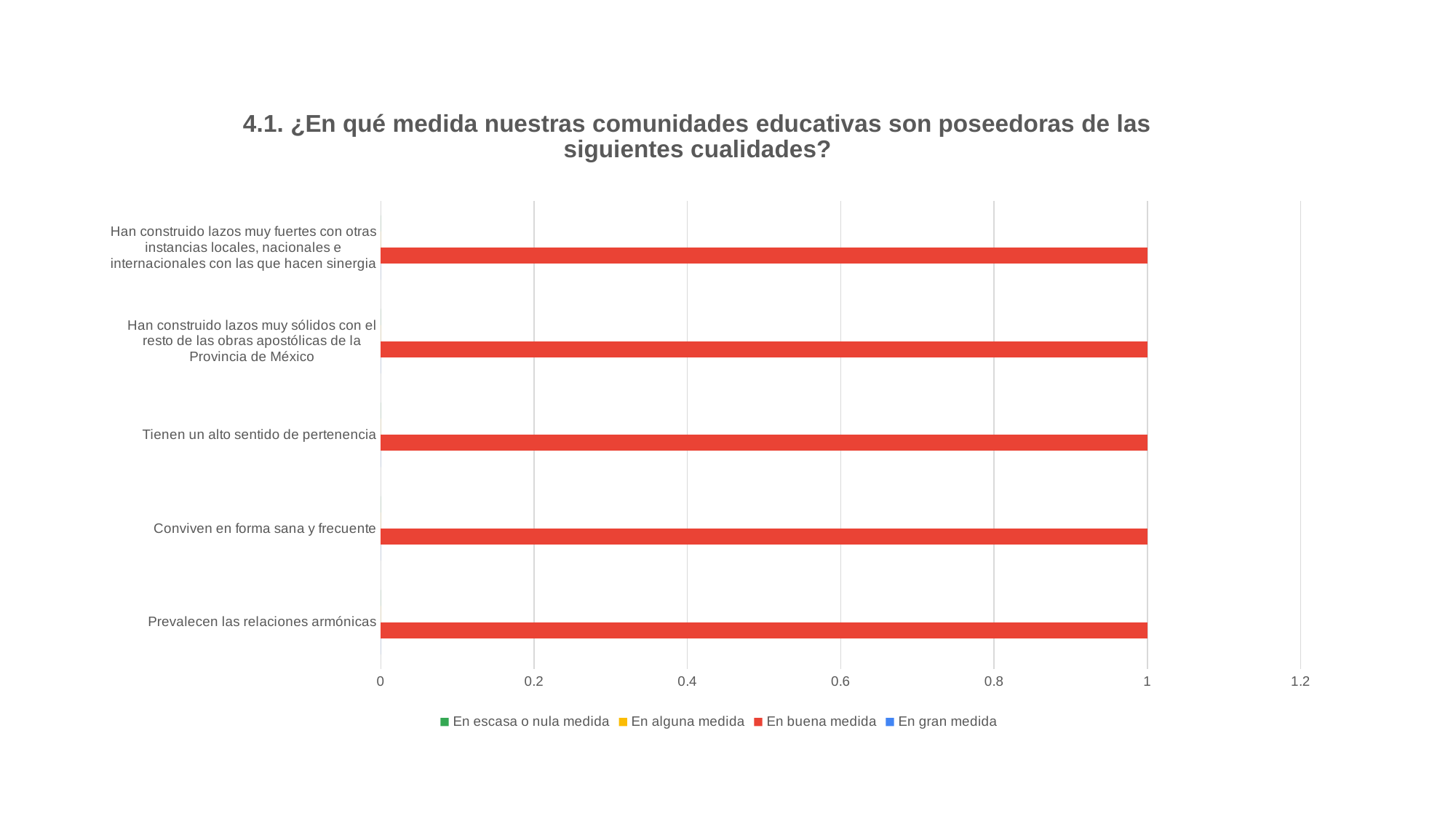
Which series in the legend is shown in red? En buena medida How many series does the legend list? 4 What is the value of the 'En buena medida' bar for 'Prevalecen las relaciones armónicas'? 1 What is the value of the 'En buena medida' bar for 'Tienen un alto sentido de pertenencia'? 1 Is the value for 'Han construido lazos muy sólidos con el resto de las obras apostólicas de la Provincia de México' greater or less than 1.2? less What is the highest value shown on the x axis? 1.2 How many categories are plotted on the chart? 5 What is the difference between the 'En buena medida' values for 'Tienen un alto sentido de pertenencia' and 'Prevalecen las relaciones armónicas'? 0 What is the title of the chart? 4.1. ¿En qué medida nuestras comunidades educativas son poseedoras de las siguientes cualidades? What kind of chart is shown on the slide? bar chart What is the value of the 'En buena medida' bar for 'Conviven en forma sana y frecuente'? 1 Is the value for 'Conviven en forma sana y frecuente' greater or less than 0.8? greater